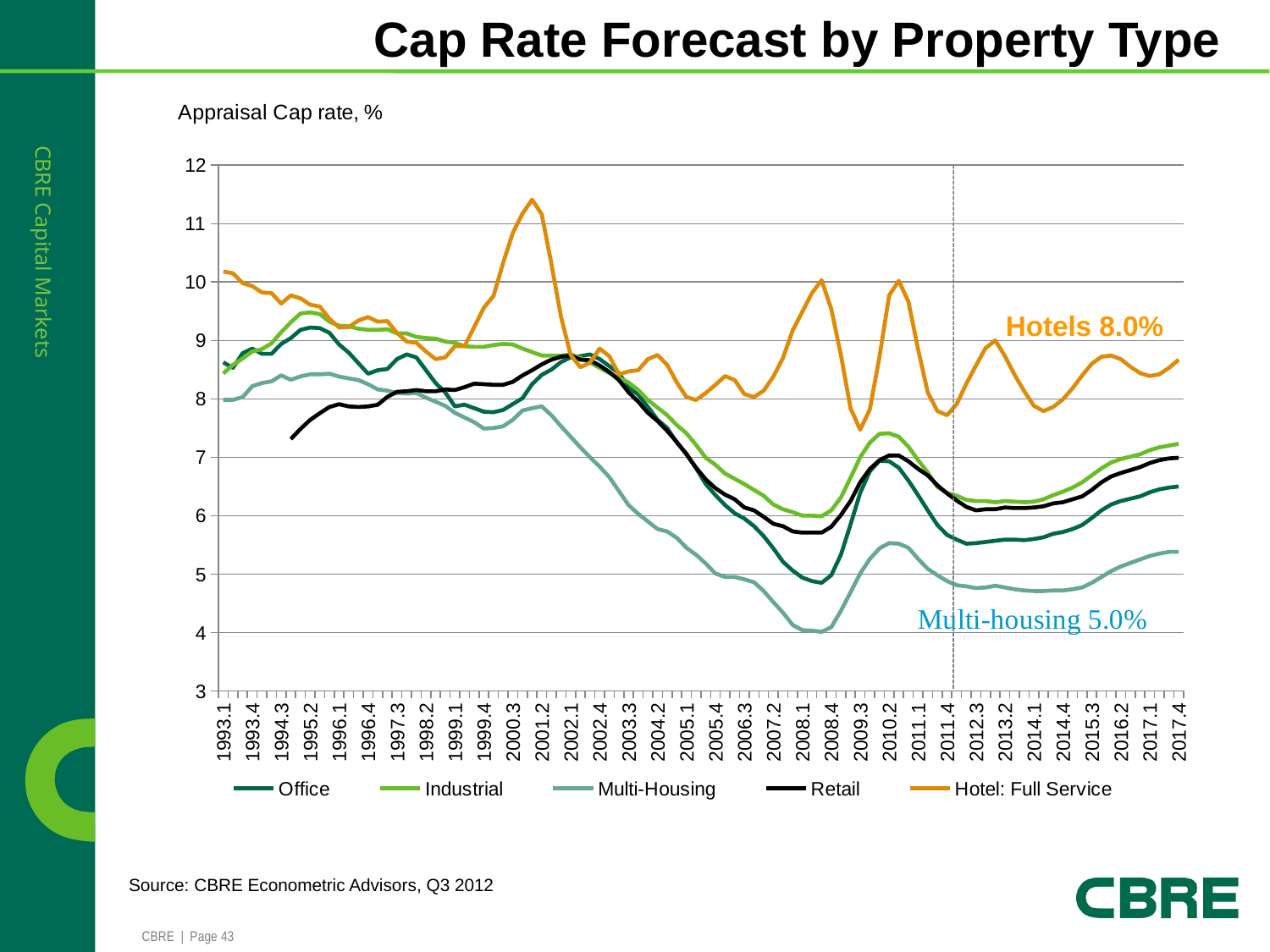
At 2008.1, which series has the higher value, Hotel: Full Service or Multi-Housing? Hotel: Full Service Which series has the highest value at 2017.4? Hotel: Full Service How many series does the legend list? 5 Is the value for Hotel: Full Service at its peak around 2001.1 greater or less than 11? greater Does the Multi-Housing series rise or fall between 2002.1 and 2008.1? fall Is the value for Office at 2017.4 greater or less than 7? less Which series has the lowest value at 2017.4? Multi-Housing What type of chart is shown on the slide? line chart What is the title of the chart? Cap Rate Forecast by Property Type What value does the annotation on the chart give for Hotels? 8.0% Is the value for Retail at 2008.1 greater or less than 6? less